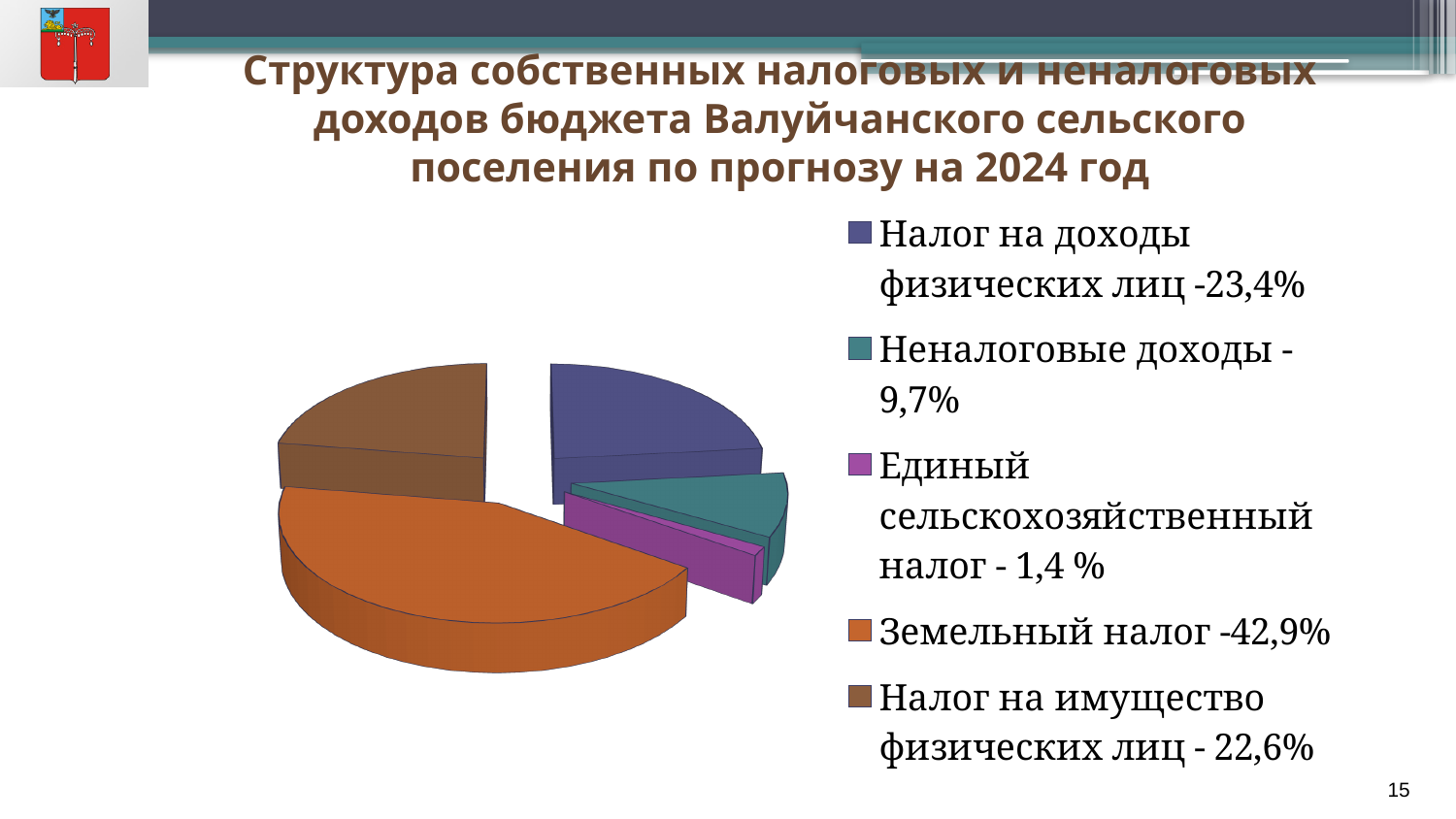
What share does Земельный налог have in the pie chart? 42,9% What share does Единый сельскохозяйственный налог have in the pie chart? 1,4 % What share does Неналоговые доходы have in the pie chart? 9,7% How many categories does the pie chart show? 5 What kind of chart is shown on the slide? Pie chart What is the difference in percentage points between Земельный налог and Налог на доходы физических лиц? 19,5 Which category has the smallest share of the pie? Единый сельскохозяйственный налог What colour is the slice for Земельный налог? Orange What share does Налог на доходы физических лиц have in the pie chart? 23,4% What share does Налог на имущество физических лиц have in the pie chart? 22,6% Which category has the largest share of the pie? Земельный налог Which is larger: the share of Неналоговые доходы or the share of Налог на имущество физических лиц? Налог на имущество физических лиц